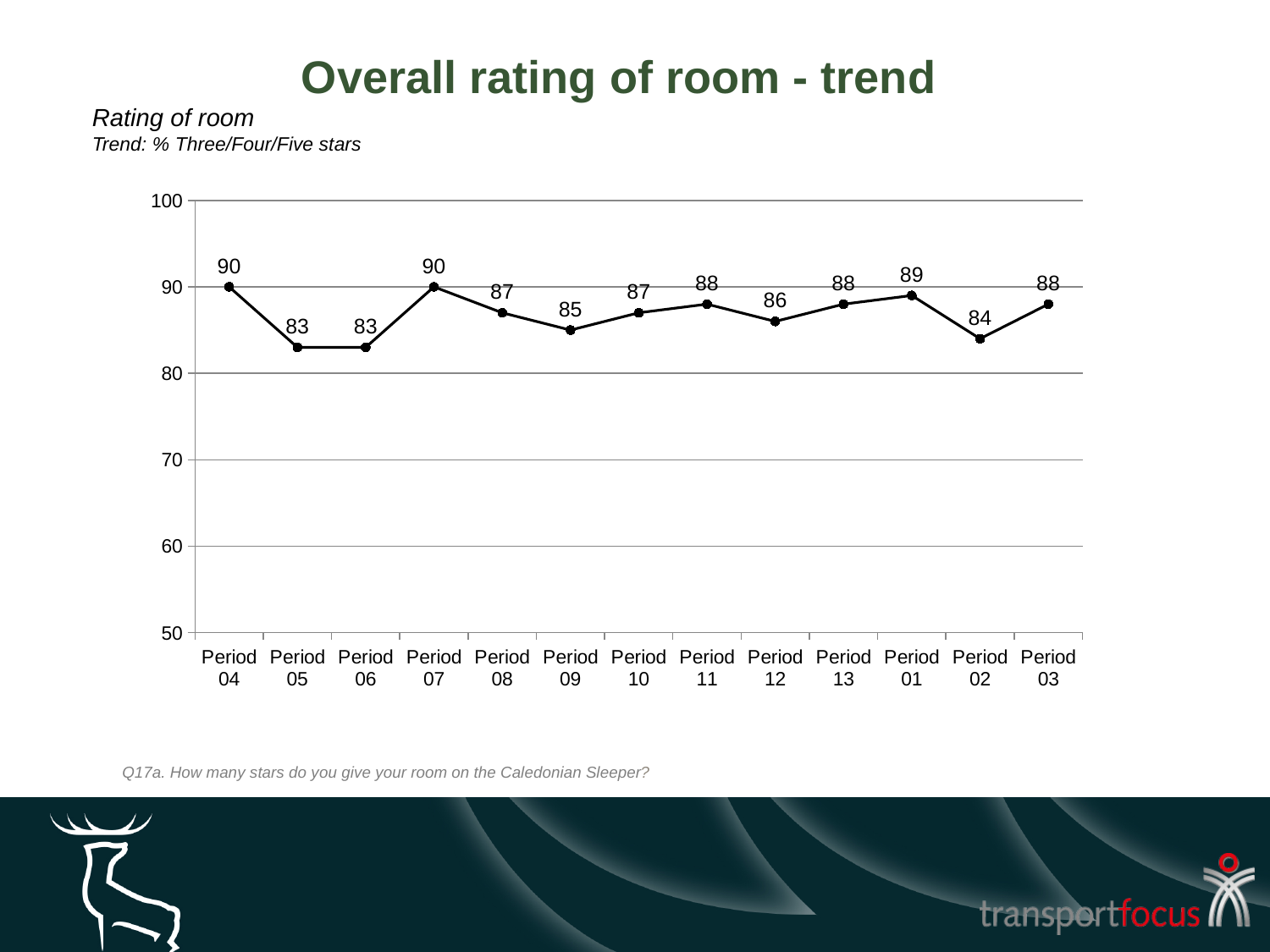
Is the value for Period 11 greater or less than 80? greater What is the value for Period 09? 85 What is the value for Period 04? 90 How many periods are plotted on the chart? 13 What is the difference between the values for Period 01 and Period 02? 5 What is the difference between the values for Period 07 and Period 08? 3 Which is larger, the value for Period 12 or the value for Period 13? Period 13 What is the value for Period 02? 84 Does the value rise or fall from Period 02 to Period 03? rise What is the value for Period 01? 89 What kind of chart is shown on the slide? line chart Which periods have the lowest value on the chart? Period 05 and Period 06